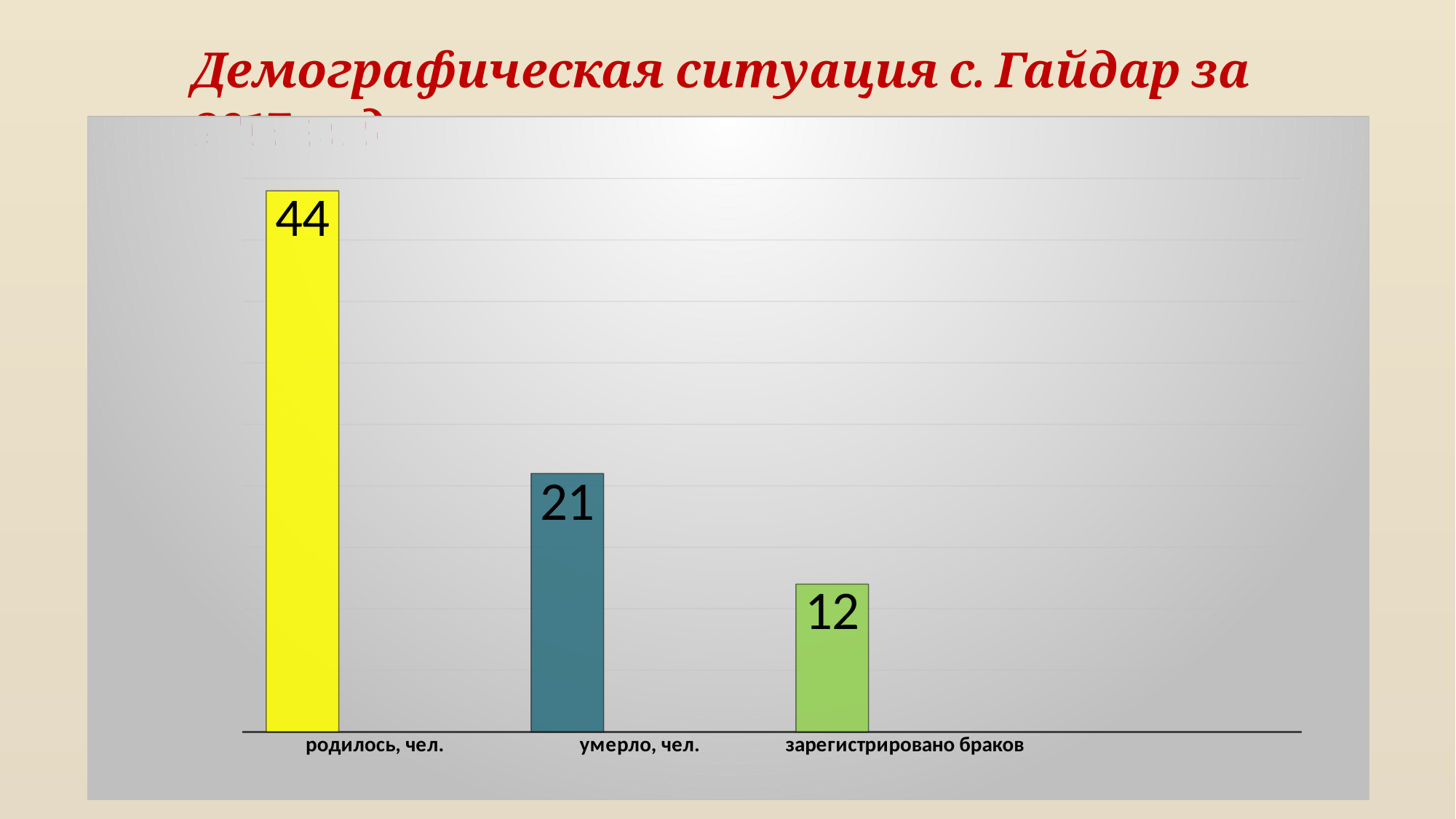
What colour is the bar for "родилось, чел."? yellow What is the difference between the values for "умерло, чел." and "зарегистрировано браков"? 9 Which category has the highest value? родилось, чел. Which is larger, the value for "умерло, чел." or the value for "зарегистрировано браков"? умерло, чел. What is the difference between the values for "родилось, чел." and "умерло, чел."? 23 Which category has the lowest value? зарегистрировано браков What is the value for "родилось, чел."? 44 What is the value for "зарегистрировано браков"? 12 What is the value for "умерло, чел."? 21 What kind of chart is shown on the slide? bar chart How many categories are shown in the chart? 3 Do the values rise or fall from left to right across the categories? fall